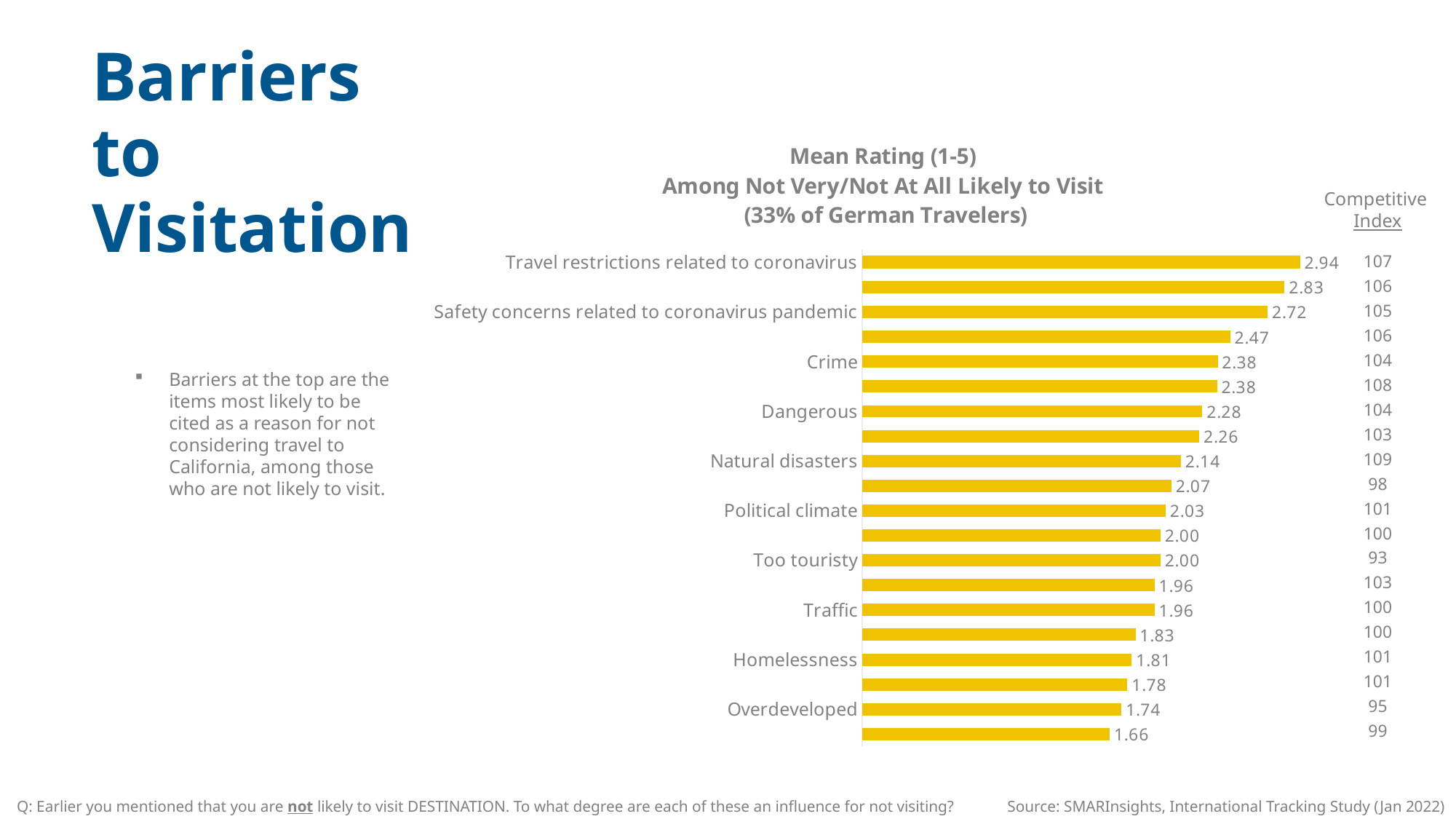
What is the mean rating for Homelessness? 1.81 How many bars are plotted on the chart? 20 What is the lowest mean rating shown on the chart? 1.66 What colour are the bars in the chart? Yellow What is the mean rating for Safety concerns related to coronavirus pandemic? 2.72 What is the Competitive Index value for Too touristy? 93 What is the mean rating for Natural disasters? 2.14 Which has a higher mean rating, Crime or Natural disasters? Crime What kind of chart is shown on the slide? Bar chart What is the mean rating for Travel restrictions related to coronavirus? 2.94 What is the difference between the mean ratings for Travel restrictions related to coronavirus and Safety concerns related to coronavirus pandemic? 0.22 Which barrier has the highest mean rating? Travel restrictions related to coronavirus